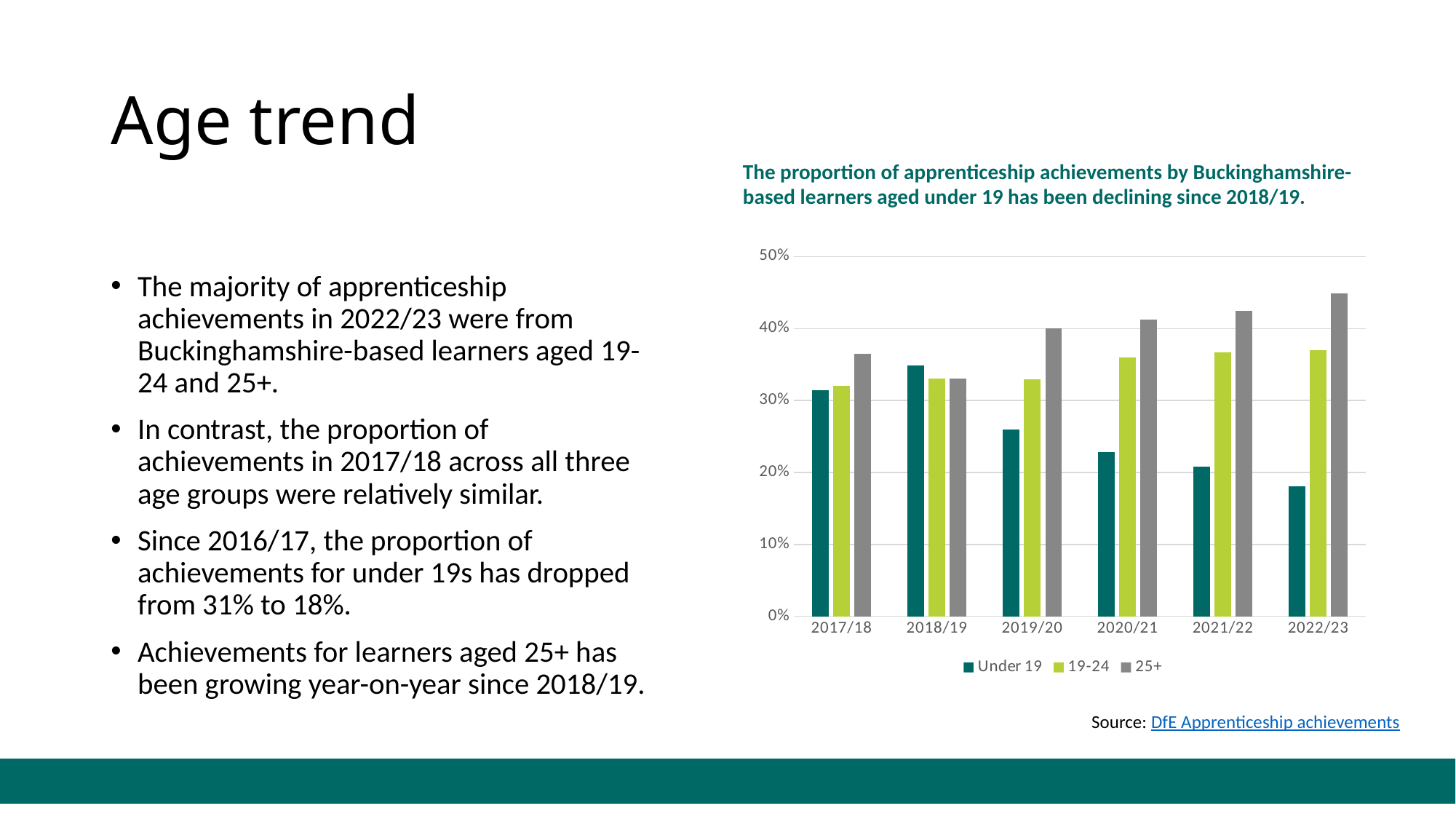
Does the value for 25+ rise or fall from 2018/19 to 2022/23? Rise Is the value for 25+ in 2022/23 greater or less than 40%? greater Which series is shown in dark teal bars? Under 19 How many series does the legend list? 3 In 2019/20, which is larger: the value for 25+ or the value for Under 19? 25+ In which year is the value for 25+ highest? 2022/23 How many academic years are shown on the x axis? 6 Is the value for Under 19 in 2022/23 greater or less than 20%? less Does the value for Under 19 rise or fall from 2018/19 to 2022/23? Fall In which year is the value for Under 19 lowest? 2022/23 What kind of chart is shown on the slide? Bar chart Is the value for Under 19 in 2018/19 greater or less than 30%? greater